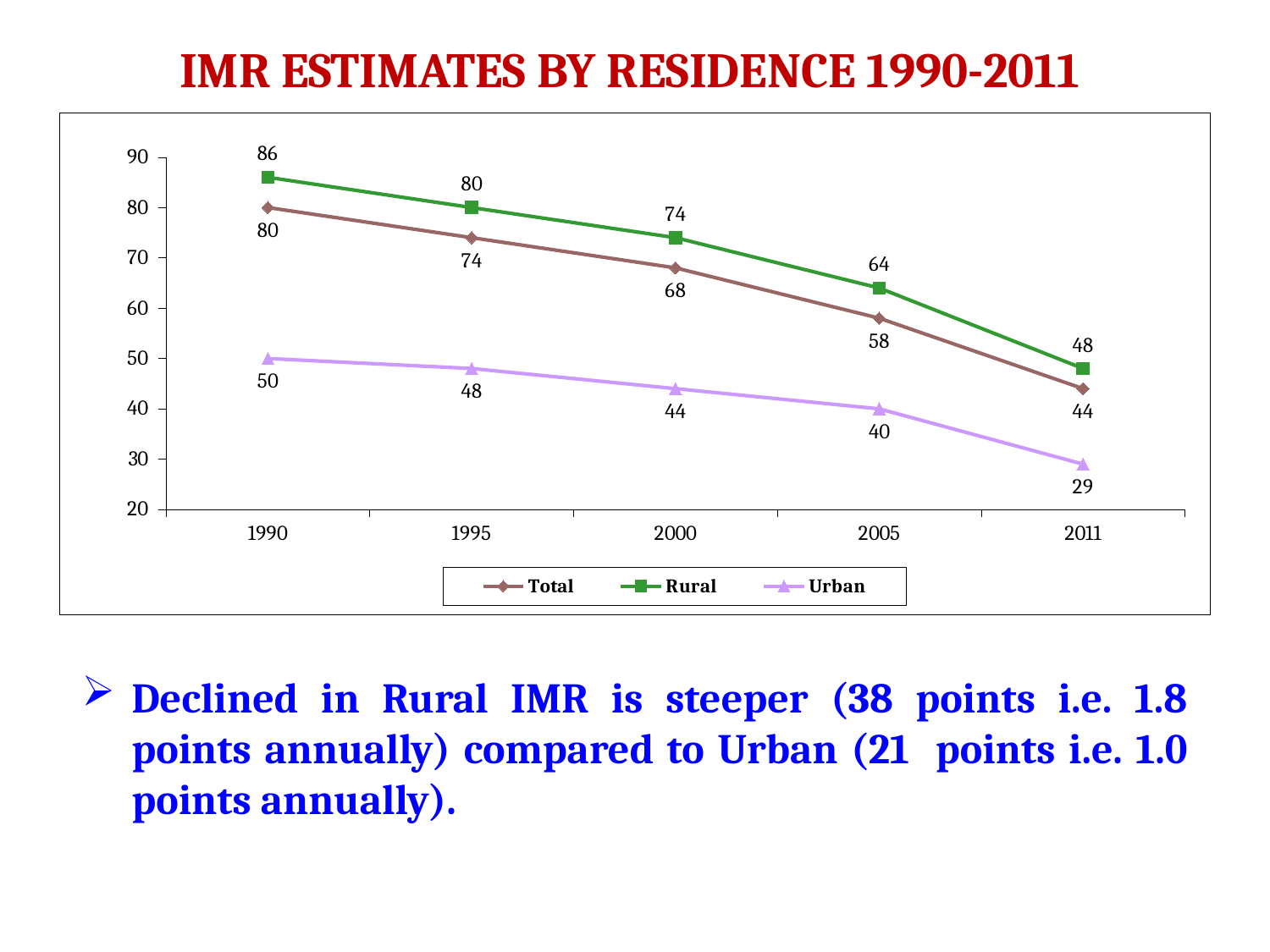
How many series does the legend list? 3 How many years are shown on the x axis? 5 What is the Rural IMR value for 1990? 86 What kind of chart is shown on the slide? Line chart Which is larger in 1995, the Rural IMR or the Total IMR? Rural What is the Total IMR value for 2000? 68 In which year is the Rural IMR lowest? 2011 What is the difference between the Rural and Urban IMR values in 2005? 24 By how much did the Total IMR decline from 1990 to 2011? 36 Do the Urban IMR values rise or fall from 1990 to 2011? Fall What is the Urban IMR value for 2011? 29 In which year is the Urban IMR highest? 1990